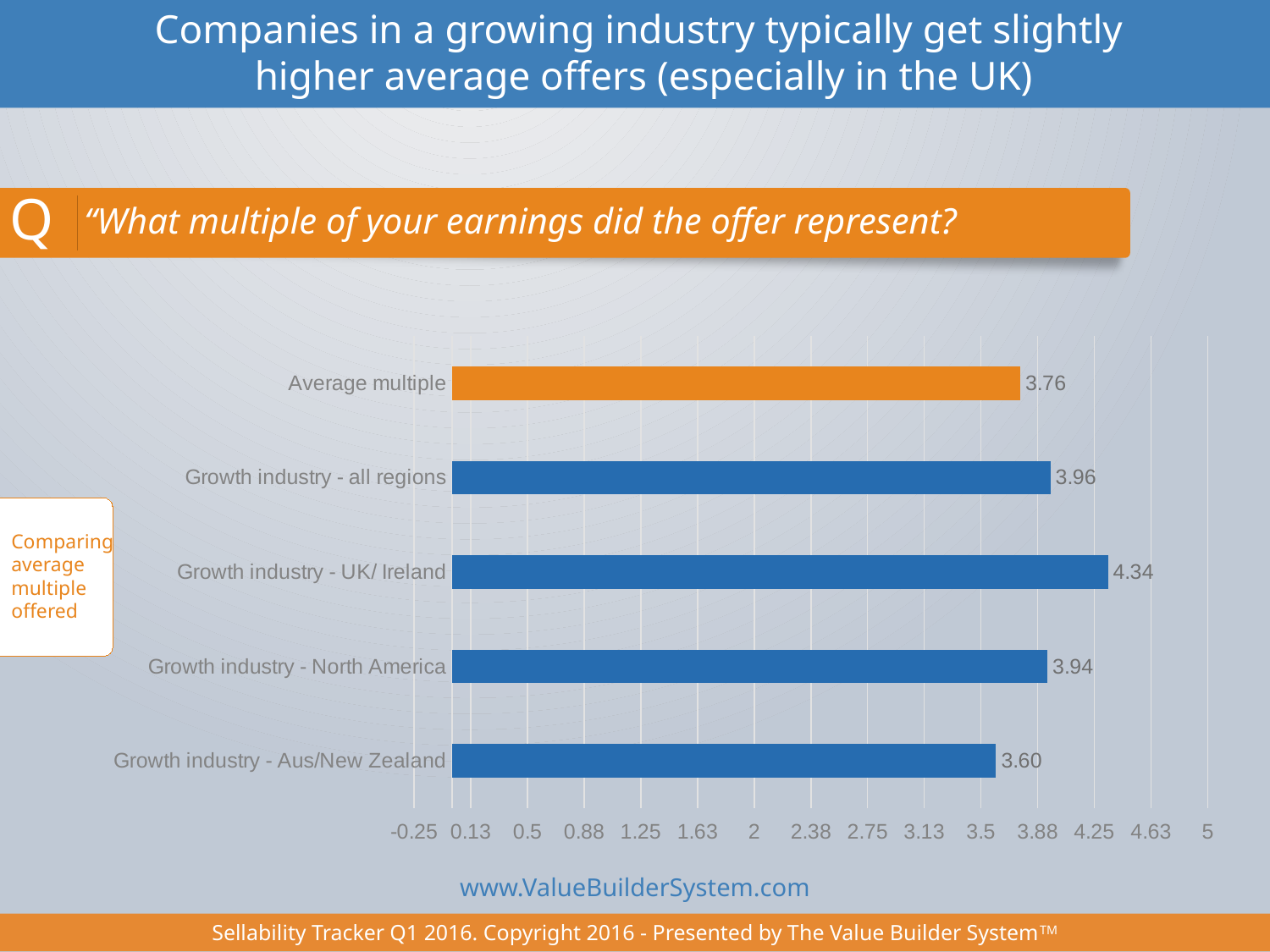
What is the value for Growth industry - Aus/New Zealand? 3.60 What kind of chart is shown on the slide? Bar chart What is the difference between the values for Growth industry - all regions and Average multiple? 0.20 Which is larger, the value for Growth industry - UK/ Ireland or the value for Average multiple? Growth industry - UK/ Ireland What is the value for Average multiple? 3.76 How many categories are shown in the chart? 5 Which bar is shown in a different colour (orange) from the others? Average multiple Which category has the highest value? Growth industry - UK/ Ireland What is the value for Growth industry - UK/ Ireland? 4.34 Which category has the lowest value? Growth industry - Aus/New Zealand What is the difference between the values for Growth industry - UK/ Ireland and Growth industry - Aus/New Zealand? 0.74 What is the value for Growth industry - North America? 3.94